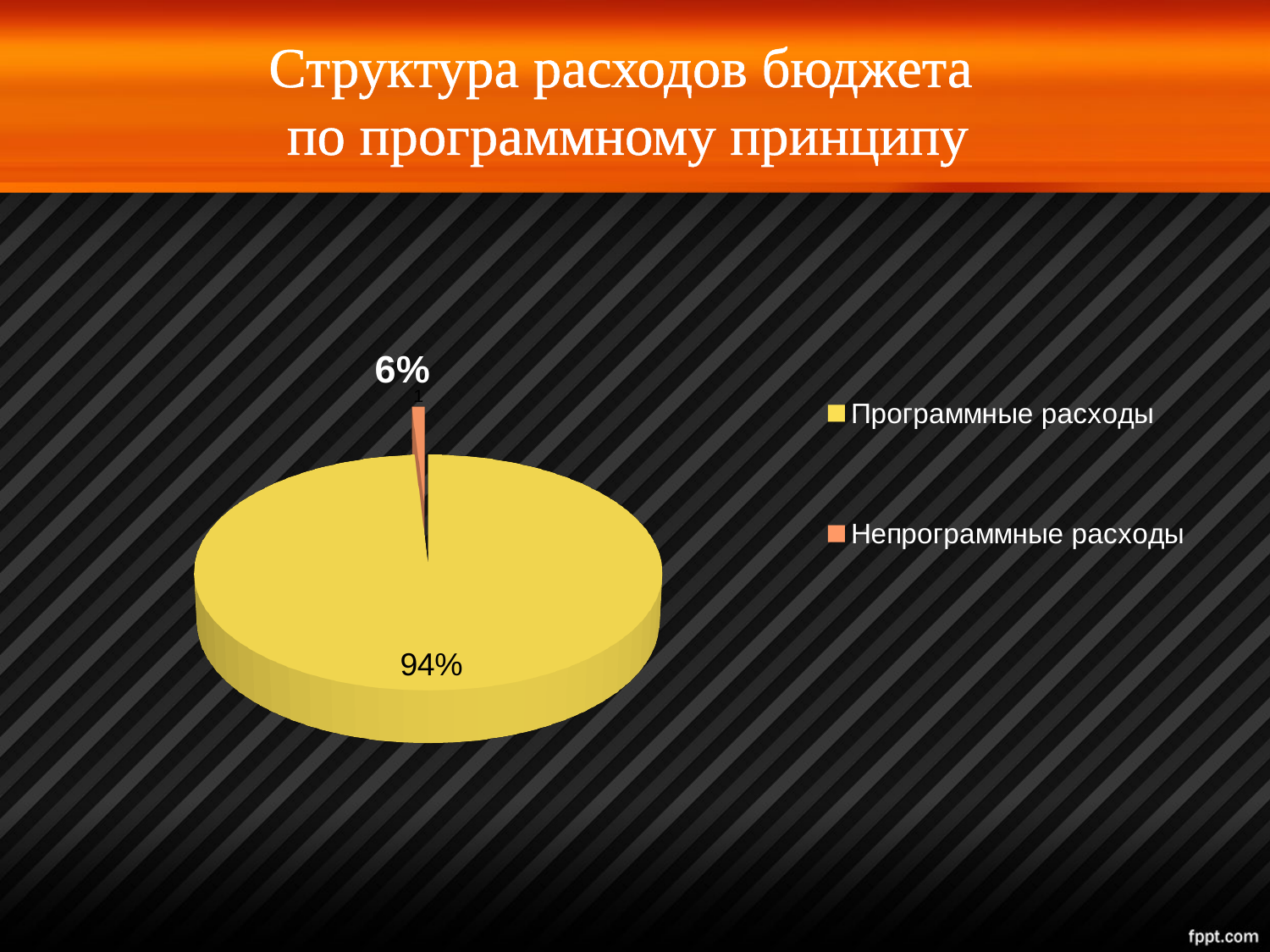
What is the title of the slide? Структура расходов бюджета по программному принципу How many entries does the legend list? 2 Which category has the largest slice of the pie? Программные расходы What kind of chart is shown on the slide? Pie chart What colour is the slice for Непрограммные расходы? Orange What share of the pie does Непрограммные расходы take? 6% Which is larger, Программные расходы or Непрограммные расходы? Программные расходы How many categories does the pie chart show? 2 What share of the pie does Программные расходы take? 94% Which category has the smallest slice of the pie? Непрограммные расходы What is the difference in percentage points between Программные расходы and Непрограммные расходы? 88